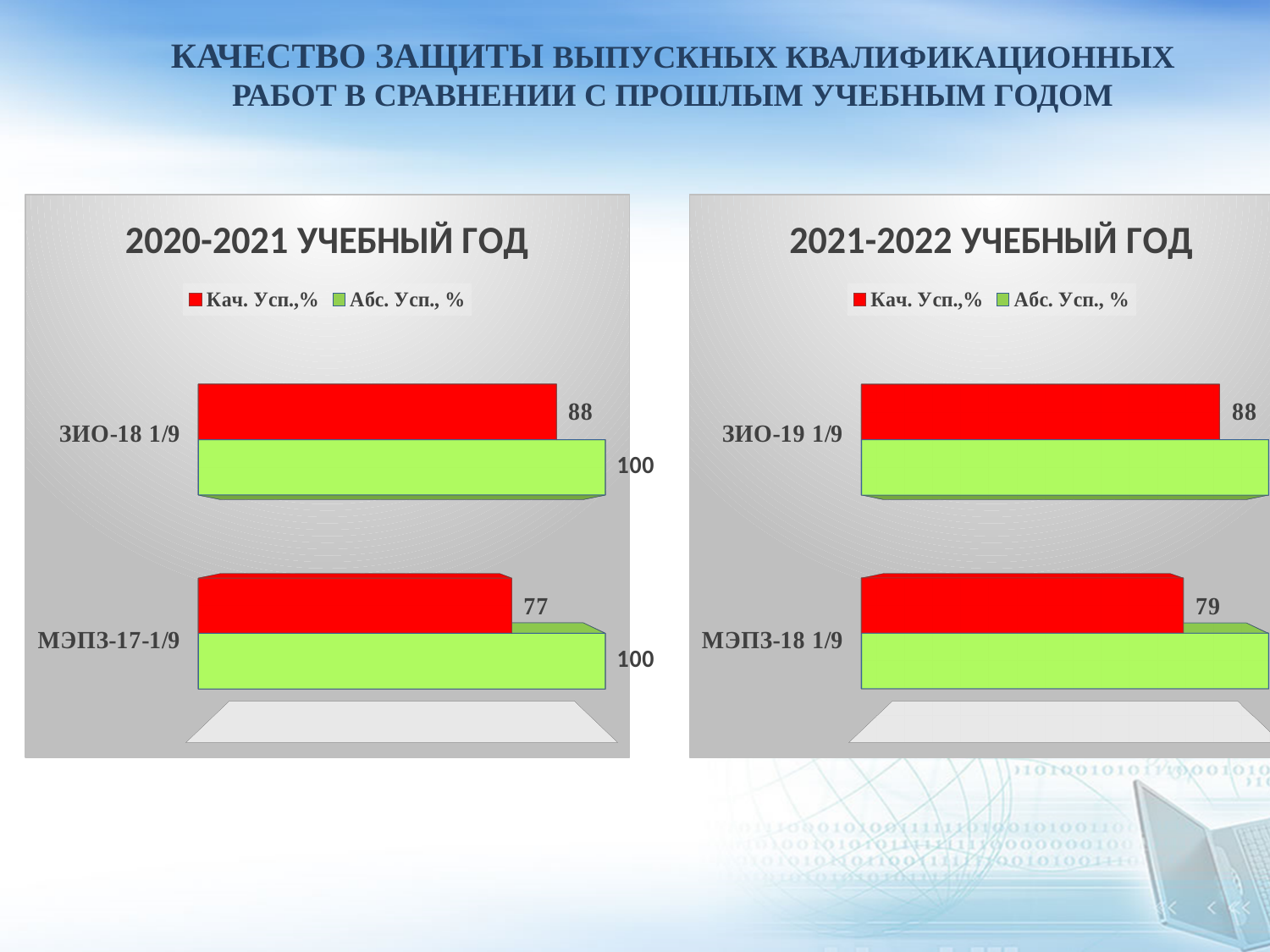
In the chart titled "2020-2021 УЧЕБНЫЙ ГОД", what is the value of Абс. Усп., % for ЗИО-18 1/9? 100 In the chart titled "2021-2022 УЧЕБНЫЙ ГОД", which category has the higher Кач. Усп.,% value? ЗИО-19 1/9 In the chart titled "2020-2021 УЧЕБНЫЙ ГОД", what is the value of Кач. Усп.,% for ЗИО-18 1/9? 88 In the chart titled "2020-2021 УЧЕБНЫЙ ГОД", what is the value of Кач. Усп.,% for МЭПЗ-17-1/9? 77 In the chart titled "2021-2022 УЧЕБНЫЙ ГОД", what is the value of Кач. Усп.,% for ЗИО-19 1/9? 88 How many categories are shown in the chart titled "2021-2022 УЧЕБНЫЙ ГОД"? 2 In the chart titled "2020-2021 УЧЕБНЫЙ ГОД", how many series does the legend list? 2 In the chart titled "2020-2021 УЧЕБНЫЙ ГОД", what is the difference between the Кач. Усп.,% values for ЗИО-18 1/9 and МЭПЗ-17-1/9? 11 In the chart titled "2021-2022 УЧЕБНЫЙ ГОД", what is the value of Кач. Усп.,% for МЭПЗ-18 1/9? 79 In the chart titled "2021-2022 УЧЕБНЫЙ ГОД", what is the difference between the Кач. Усп.,% values for ЗИО-19 1/9 and МЭПЗ-18 1/9? 9 What kind of chart is the chart titled "2020-2021 УЧЕБНЫЙ ГОД"? Bar chart In the chart titled "2020-2021 УЧЕБНЫЙ ГОД", which category has the lower Кач. Усп.,% value? МЭПЗ-17-1/9